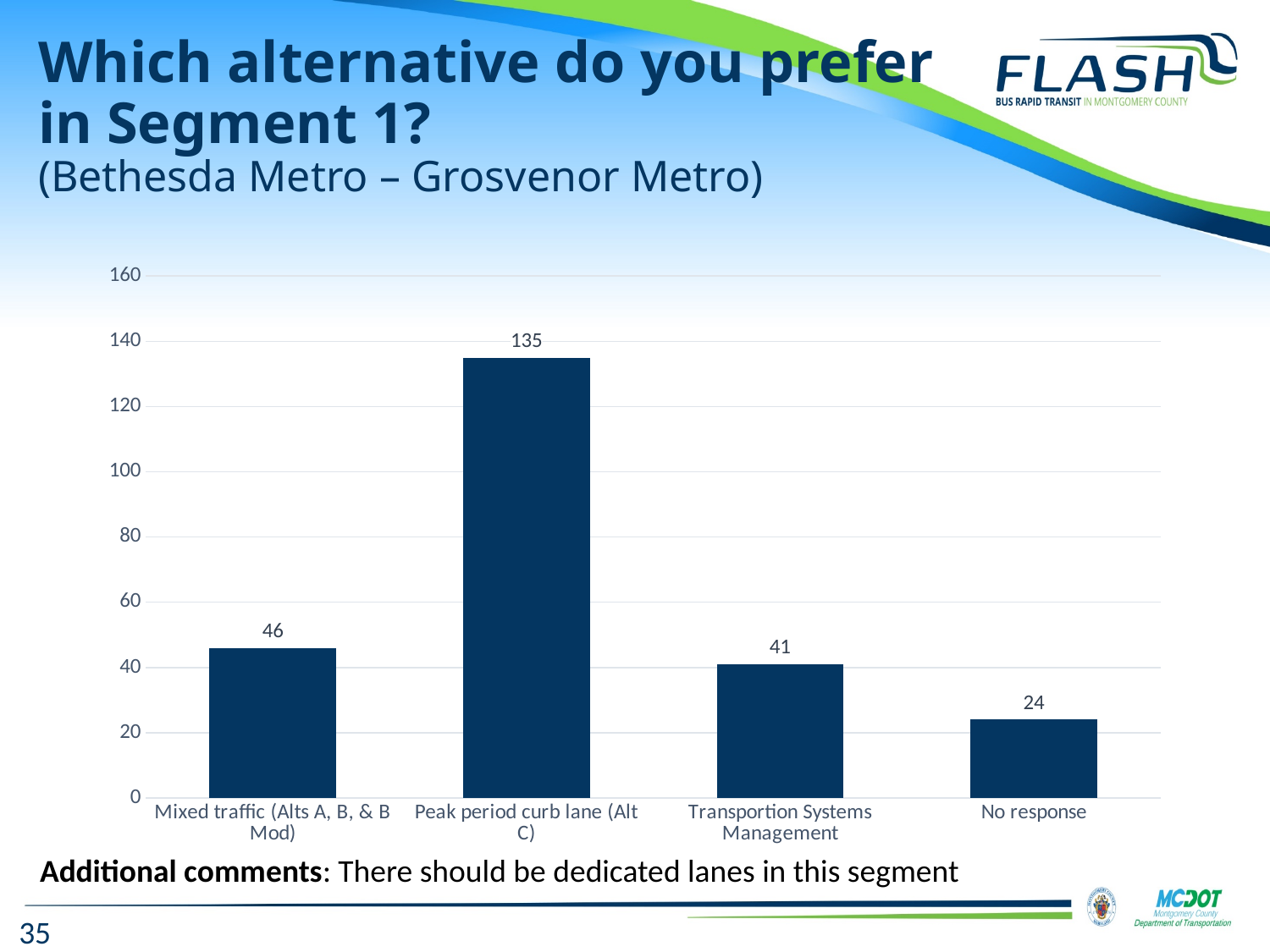
What is the value for Transportion Systems Management? 41 What is the difference between the values for Transportion Systems Management and No response? 17 Which is larger, the value for Mixed traffic (Alts A, B, & B Mod) or the value for Transportion Systems Management? Mixed traffic (Alts A, B, & B Mod) How many categories are shown on the x axis? 4 What is the value for Mixed traffic (Alts A, B, & B Mod)? 46 Which category has the lowest value? No response What is the value for No response? 24 Which category has the highest value? Peak period curb lane (Alt C) What is the difference between the values for Peak period curb lane (Alt C) and Mixed traffic (Alts A, B, & B Mod)? 89 Is the value for Peak period curb lane (Alt C) greater or less than 120? greater What is the value for Peak period curb lane (Alt C)? 135 What kind of chart is shown on the slide? bar chart